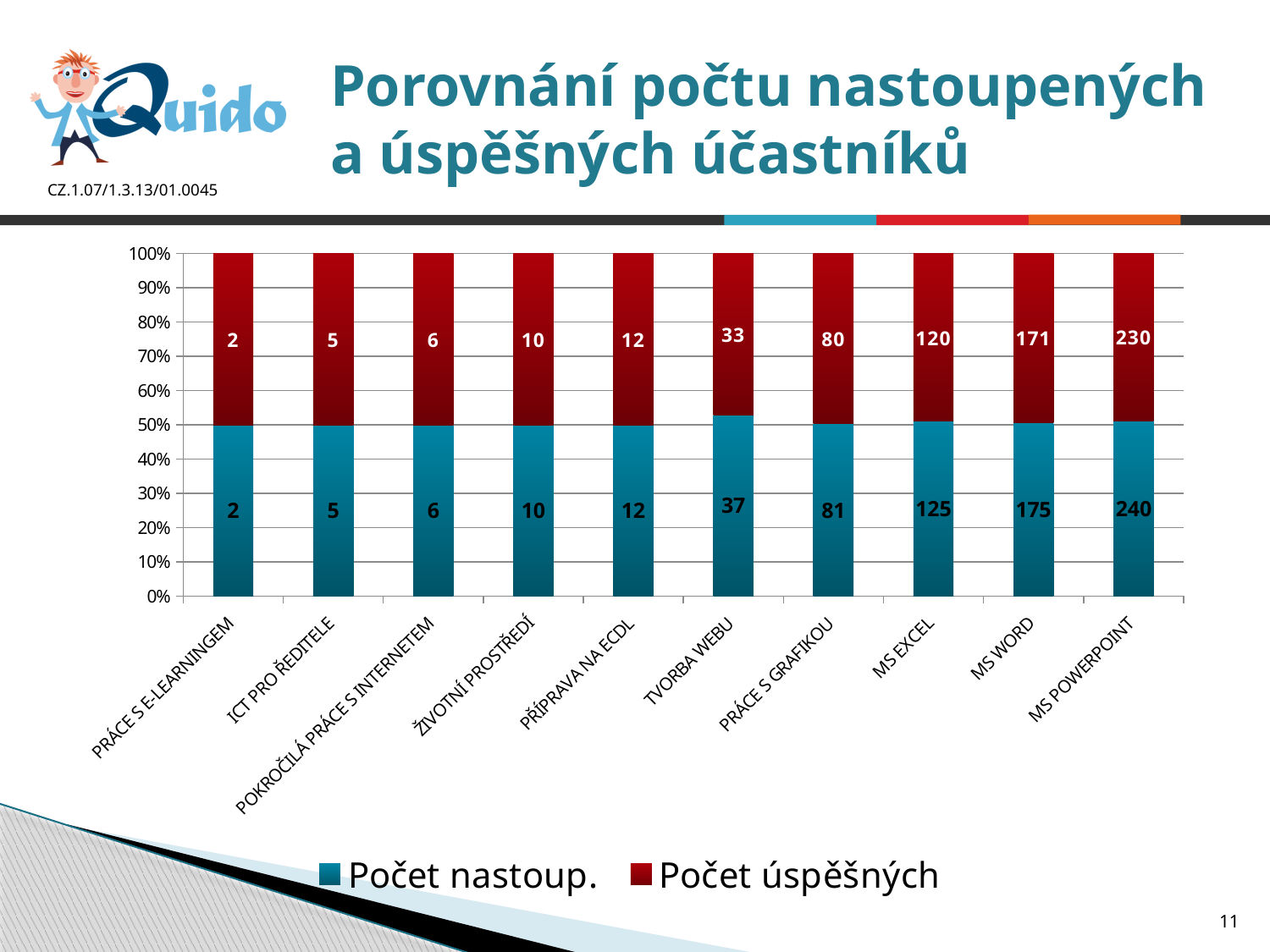
How many categories are shown on the x axis of the chart? 10 What is the value of Počet úspěšných for TVORBA WEBU? 33 What is the value of Počet nastoup. for MS POWERPOINT? 240 How many series does the legend list? 2 What kind of chart is shown on the slide? Stacked bar chart Which category has the lowest value of Počet úspěšných? PRÁCE S E-LEARNINGEM What is the value of Počet nastoup. for PRÁCE S GRAFIKOU? 81 What is the value of Počet úspěšných for MS WORD? 171 Which is larger: Počet úspěšných for PRÁCE S GRAFIKOU or Počet úspěšných for TVORBA WEBU? PRÁCE S GRAFIKOU What is the difference between Počet nastoup. and Počet úspěšných for MS EXCEL? 5 What is the difference between Počet nastoup. for MS WORD and Počet nastoup. for MS EXCEL? 50 Which category has the highest value of Počet nastoup.? MS POWERPOINT